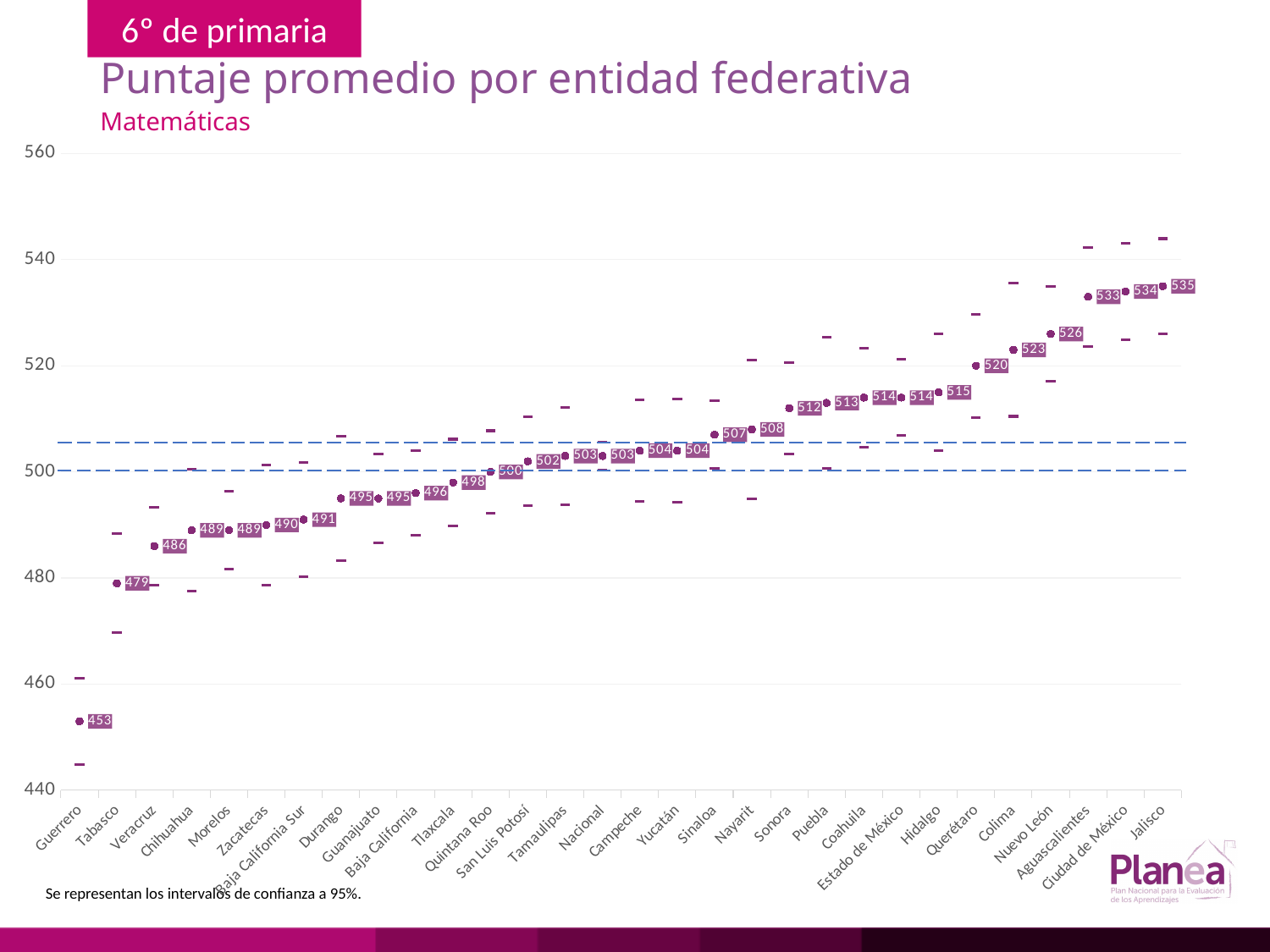
What is the value plotted for Nacional? 503 Which entity has the lowest average score on the chart? Guerrero What is the difference between the scores of Jalisco and Guerrero? 82 Which entity has the highest average score on the chart? Jalisco Is the value for Ciudad de México greater or less than 520? greater What is the average mathematics score shown for Guerrero? 453 Do the plotted values rise or fall from left to right along the x axis? rise How many entities (including Nacional) are plotted along the x axis? 30 Which has a higher score, Colima or Sonora? Colima What is the difference between the scores of Nuevo León and Tabasco? 47 What is the title of the chart? Puntaje promedio por entidad federativa What is the value shown for Querétaro? 520